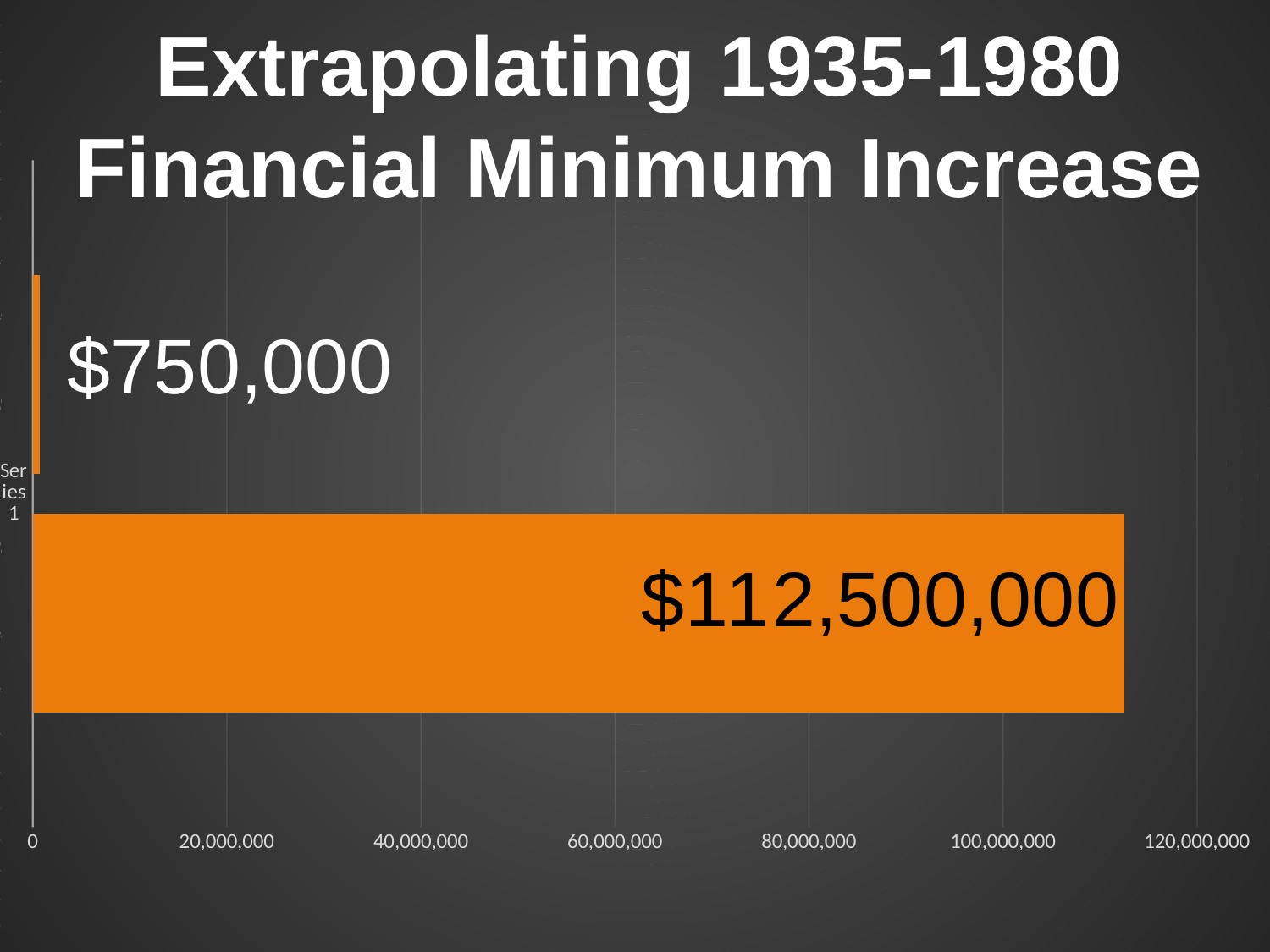
Which bar is larger, the top bar or the bottom bar? the bottom bar What kind of chart is shown on the slide? bar chart What value is labelled on the bottom (larger) bar? $112,500,000 What value is labelled on the top (smaller) bar? $750,000 What is the smallest value shown in the chart? $750,000 Is the value of the bottom bar greater or less than 100,000,000? greater What is the difference between the two bar values, $112,500,000 and $750,000? $111,750,000 What is the largest value shown in the chart? $112,500,000 What is the highest tick value shown on the horizontal axis? 120,000,000 What is the title of the slide? Extrapolating 1935-1980 Financial Minimum Increase How many bars are plotted in the chart? 2 Is the value of the top bar greater or less than 20,000,000? less